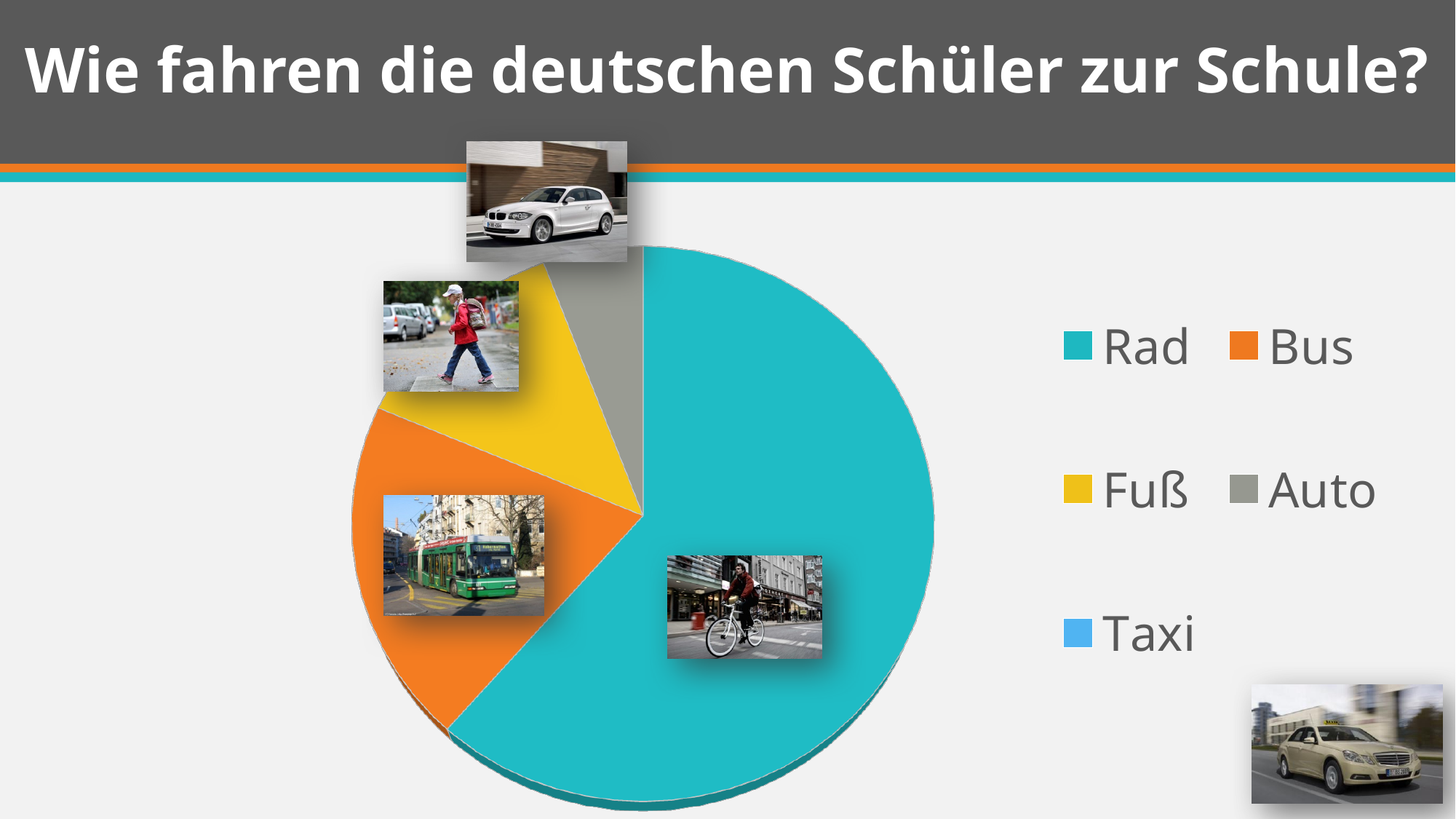
Which category has the largest slice of the pie chart? Rad What kind of chart is shown on the slide? pie chart What colour represents Bus in the pie chart? orange Which slice is larger, Rad or Bus? Rad What is the title of the slide? Wie fahren die deutschen Schüler zur Schule? Which slice is larger, Fuß or Auto? Fuß Is the Rad slice more or less than half of the pie? more Which slice is larger, Bus or Auto? Bus How many categories does the legend of the pie chart list? 5